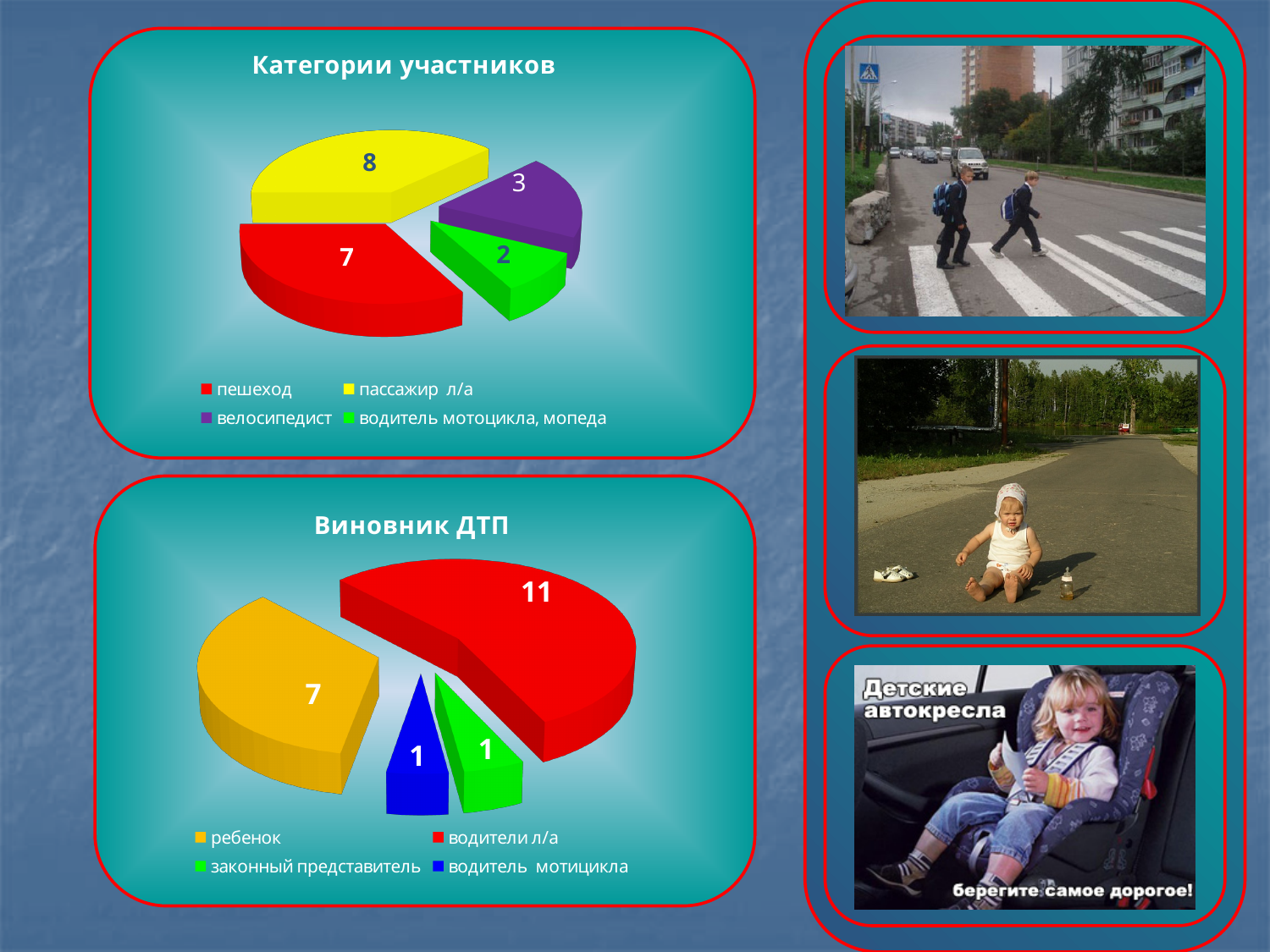
In the chart titled "Категории участников", which category has the lowest value? водитель мотоцикла, мопеда In the chart titled "Виновник ДТП", what is the value for "ребенок"? 7 In the chart titled "Категории участников", what is the difference between the values for "пассажир л/а" and "велосипедист"? 5 In the chart titled "Категории участников", what is the value for "пешеход"? 7 In the chart titled "Категории участников", how many categories does the legend list? 4 In the chart titled "Категории участников", which category has the highest value? пассажир л/а In the chart titled "Виновник ДТП", what share of the total does "водители л/а" represent? 55% In the chart titled "Виновник ДТП", which category has the highest value? водители л/а What type of chart is the chart titled "Виновник ДТП"? Pie chart In the chart titled "Категории участников", what is the value for "велосипедист"? 3 In the chart titled "Виновник ДТП", which is larger, the value for "ребенок" or the value for "законный представитель"? ребенок In the chart titled "Виновник ДТП", what is the value for "водители л/а"? 11